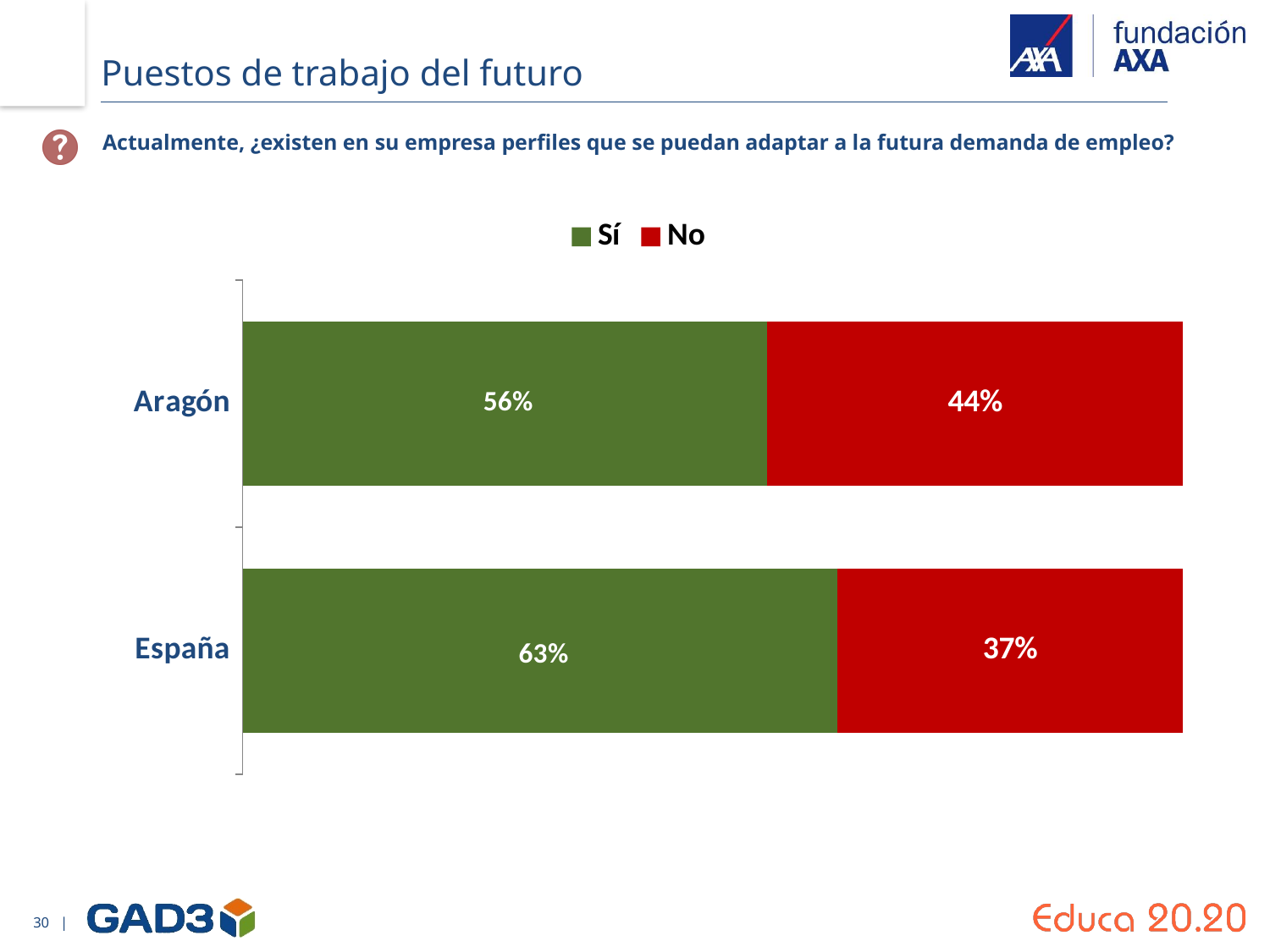
What is the 'Sí' value for Aragón? 56% What is the 'Sí' value for España? 63% What is the total of the stacked bar for España? 100% What is the 'No' value for España? 37% What kind of chart is shown on the slide? Stacked bar chart What is the difference between the 'Sí' values for España and Aragón? 7% Which category has the highest 'No' value? Aragón What is the 'No' value for Aragón? 44% How many categories are shown on the chart? 2 What is the difference between the 'Sí' and 'No' values for Aragón? 12% Which category has the higher 'Sí' value, Aragón or España? España How many series does the legend list? 2